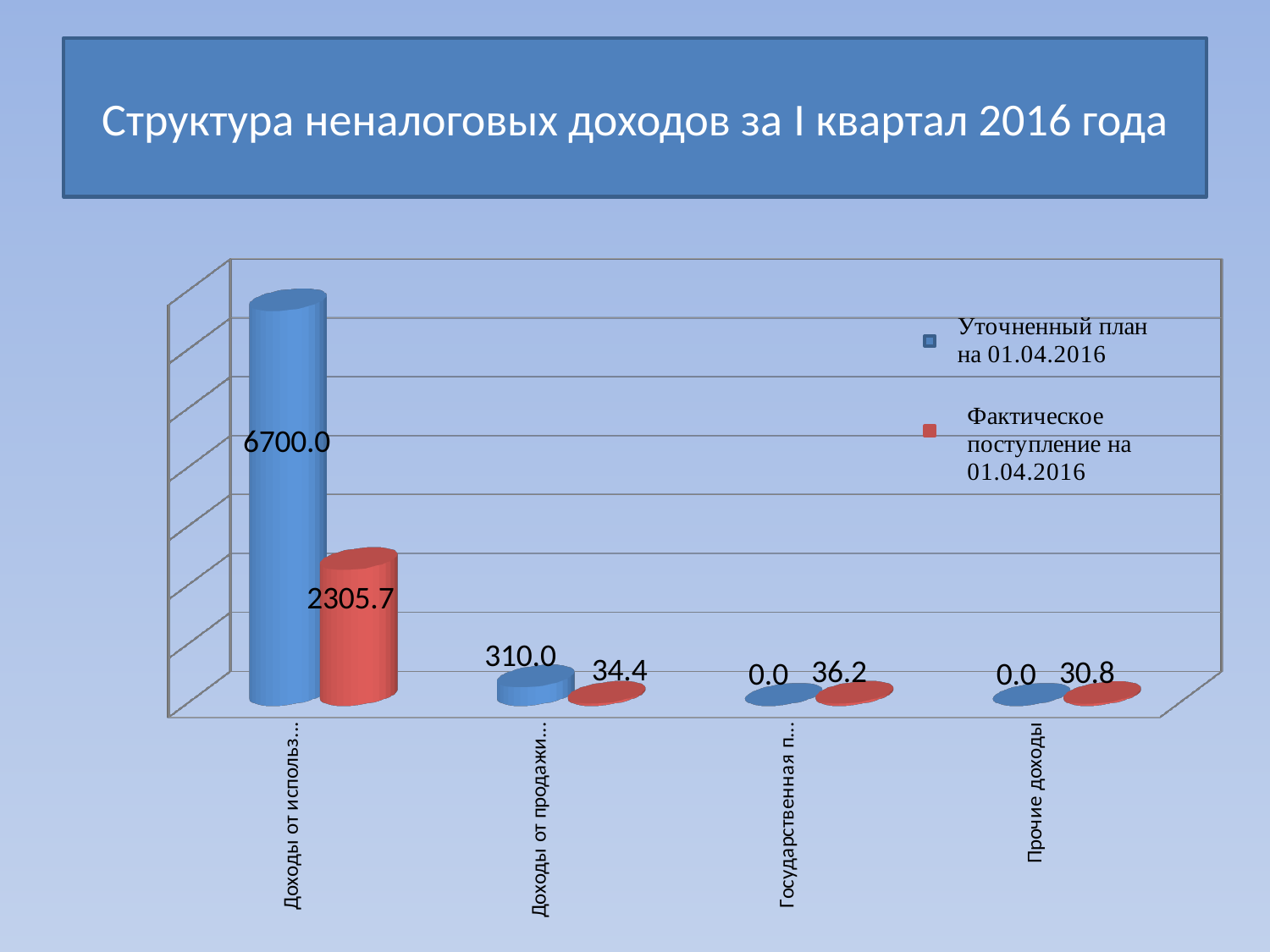
What is the value of 'Уточненный план на 01.04.2016' for the first category (Доходы от использ...)? 6700.0 For the second category (Доходы от продажи...), which is larger: 'Уточненный план на 01.04.2016' or 'Фактическое поступление на 01.04.2016'? Уточненный план на 01.04.2016 What is the difference between 'Уточненный план на 01.04.2016' and 'Фактическое поступление на 01.04.2016' for the first category (Доходы от использ...)? 4394.3 Which category has the highest value for 'Уточненный план на 01.04.2016'? Доходы от использ... What is the value of 'Фактическое поступление на 01.04.2016' for the first category (Доходы от использ...)? 2305.7 What is the title of the chart on the slide? Структура неналоговых доходов за I квартал 2016 года How many series does the chart legend list? 2 Which colour represents 'Фактическое поступление на 01.04.2016' in the chart? red What is the value of 'Уточненный план на 01.04.2016' for 'Прочие доходы'? 0.0 What type of chart is shown on the slide? bar chart What is the value of 'Фактическое поступление на 01.04.2016' for 'Прочие доходы'? 30.8 How many categories are shown on the x axis of the chart? 4